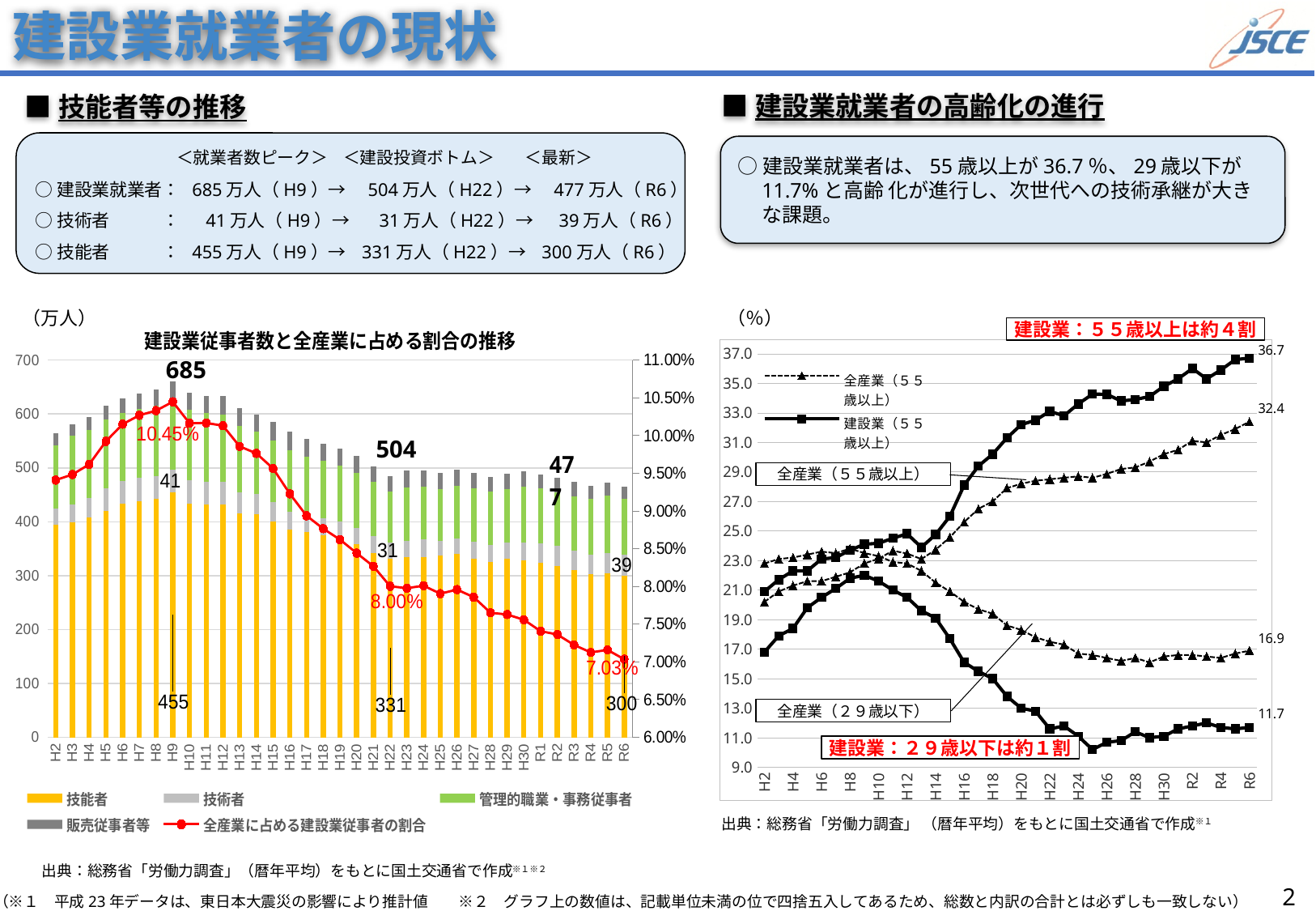
How many series does the legend of the left chart list? 5 In the right chart, what is the difference between 建設業（55歳以上） (36.7) and 全産業（55歳以上） (32.4) in R6? 4.3 In the left chart, what is the value for 技術者 in R6? 39 In the left chart, what is the value for 技能者 in H22? 331 In the left chart, by how much did the 技能者 value fall from H9 (455) to R6 (300)? 155 In the left chart, does the 全産業に占める建設業従事者の割合 line generally rise or fall from H9 to R6? fall In the left chart, what is the total labelled above the stacked bar for H9? 685 In the left chart, what is the value of 全産業に占める建設業従事者の割合 in R6? 7.03% In the right chart (%), what is the value of 建設業（55歳以上） in R6? 36.7 In the right chart, what is the value of 建設業（29歳以下） in R6? 11.7 In the right chart, which is higher in R6: 全産業（29歳以下） or 建設業（29歳以下）? 全産業（29歳以下） In the left chart (建設業従事者数と全産業に占める割合の推移), what is the value of 全産業に占める建設業従事者の割合 in H9? 10.45%